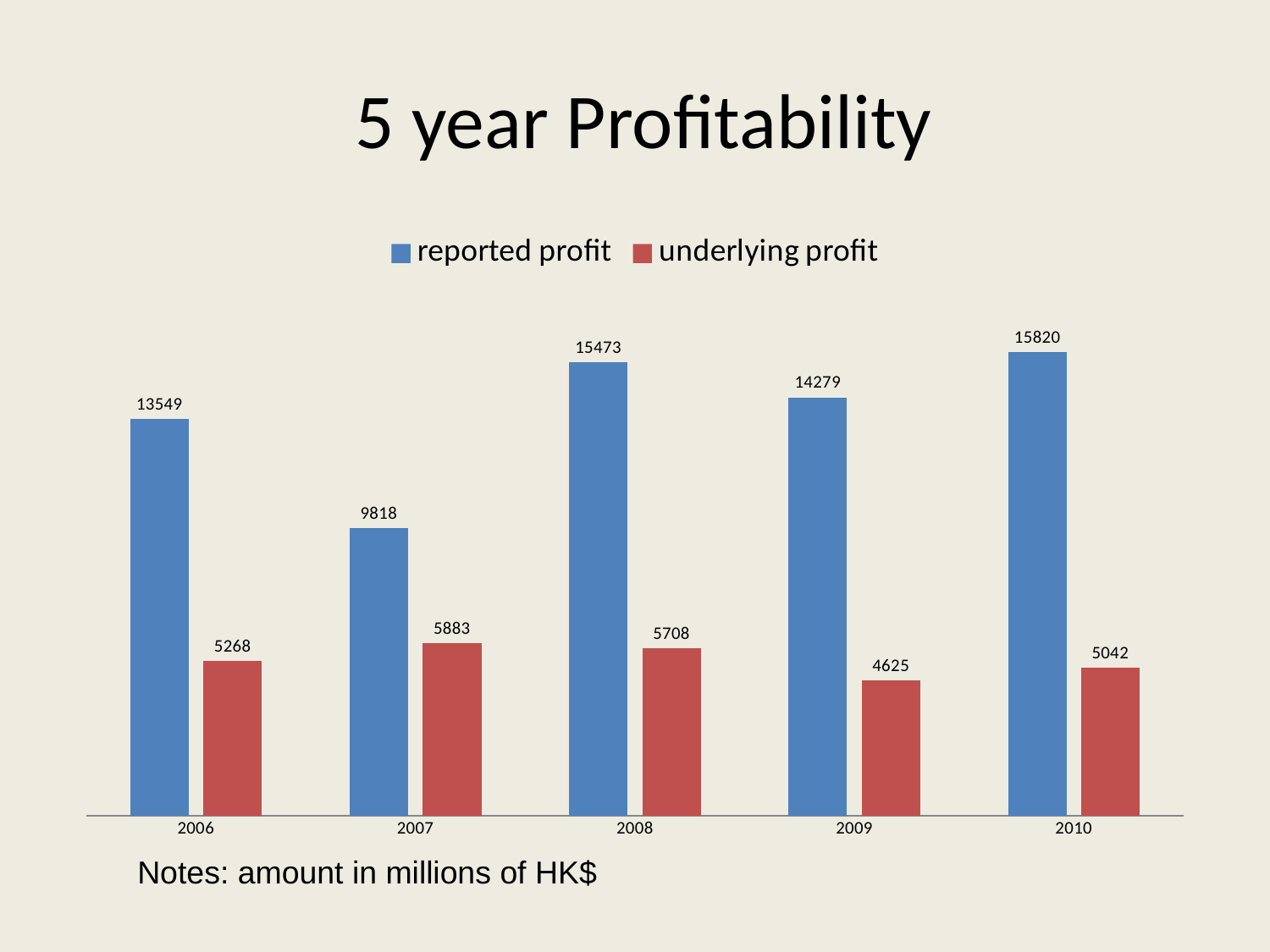
What is the difference between reported profit and underlying profit in 2010? 10778 Which year has the highest reported profit? 2010 Which is larger, the underlying profit in 2007 or the underlying profit in 2008? 2007 What is the title of the chart? 5 year Profitability Which year has the lowest reported profit? 2007 What kind of chart is shown on the slide? bar chart How many series does the legend list? 2 Which year has the lowest underlying profit? 2009 What is the reported profit for 2008? 15473 How many years are shown on the x axis? 5 What is the reported profit for 2007? 9818 What is the underlying profit for 2009? 4625